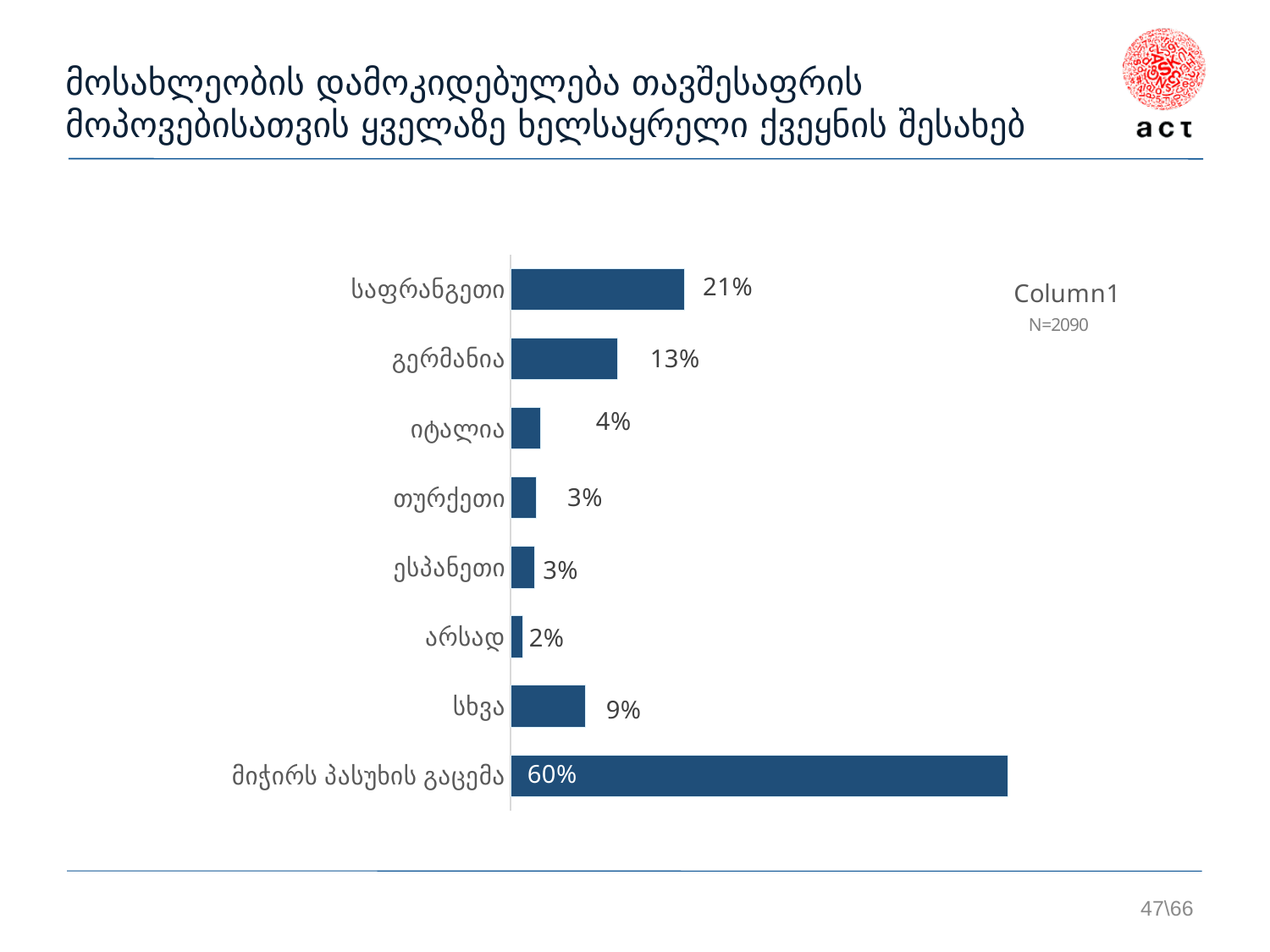
What is the difference between the values for საფრანგეთი and გერმანია? 8% What is the value for არსად? 2% Which category has the highest value? მიჭირს პასუხის გაცემა What is the value for სხვა? 9% How many categories are shown in the chart? 8 What sample size (N) is shown on the slide? N=2090 Which is larger, the value for იტალია or the value for სხვა? სხვა What is the legend entry shown next to the chart? Column1 What is the value for გერმანია? 13% What is the value for საფრანგეთი? 21% What kind of chart is shown on the slide? bar chart Which category has the lowest value? არსად